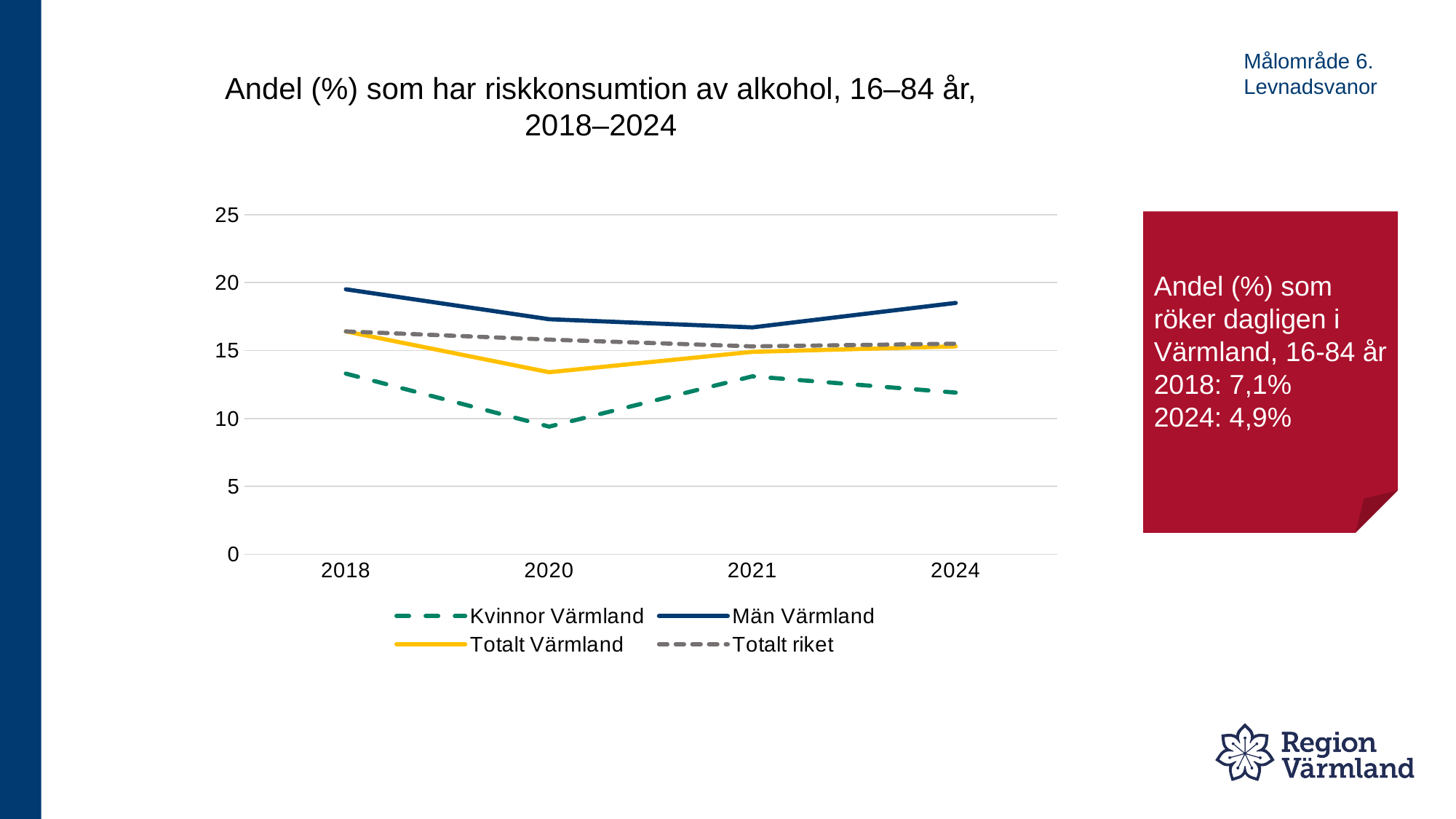
Is the value for Totalt Värmland in 2020 greater or less than 15? less Does the value for Män Värmland rise or fall from 2021 to 2024? rise Is the value for Kvinnor Värmland in 2020 greater or less than 15? less Is the value for Män Värmland in 2018 greater or less than 15? greater How many years are shown on the x axis of the chart? 4 In 2024, which is larger: the value for Män Värmland or for Kvinnor Värmland? Män Värmland Does the value for Kvinnor Värmland rise or fall from 2018 to 2020? fall Which series has the lowest value in 2020? Kvinnor Värmland What is the title of the chart? Andel (%) som har riskkonsumtion av alkohol, 16–84 år, 2018–2024 Which series has the highest value in 2018? Män Värmland What kind of chart is shown on the slide? line chart How many series does the chart legend list? 4